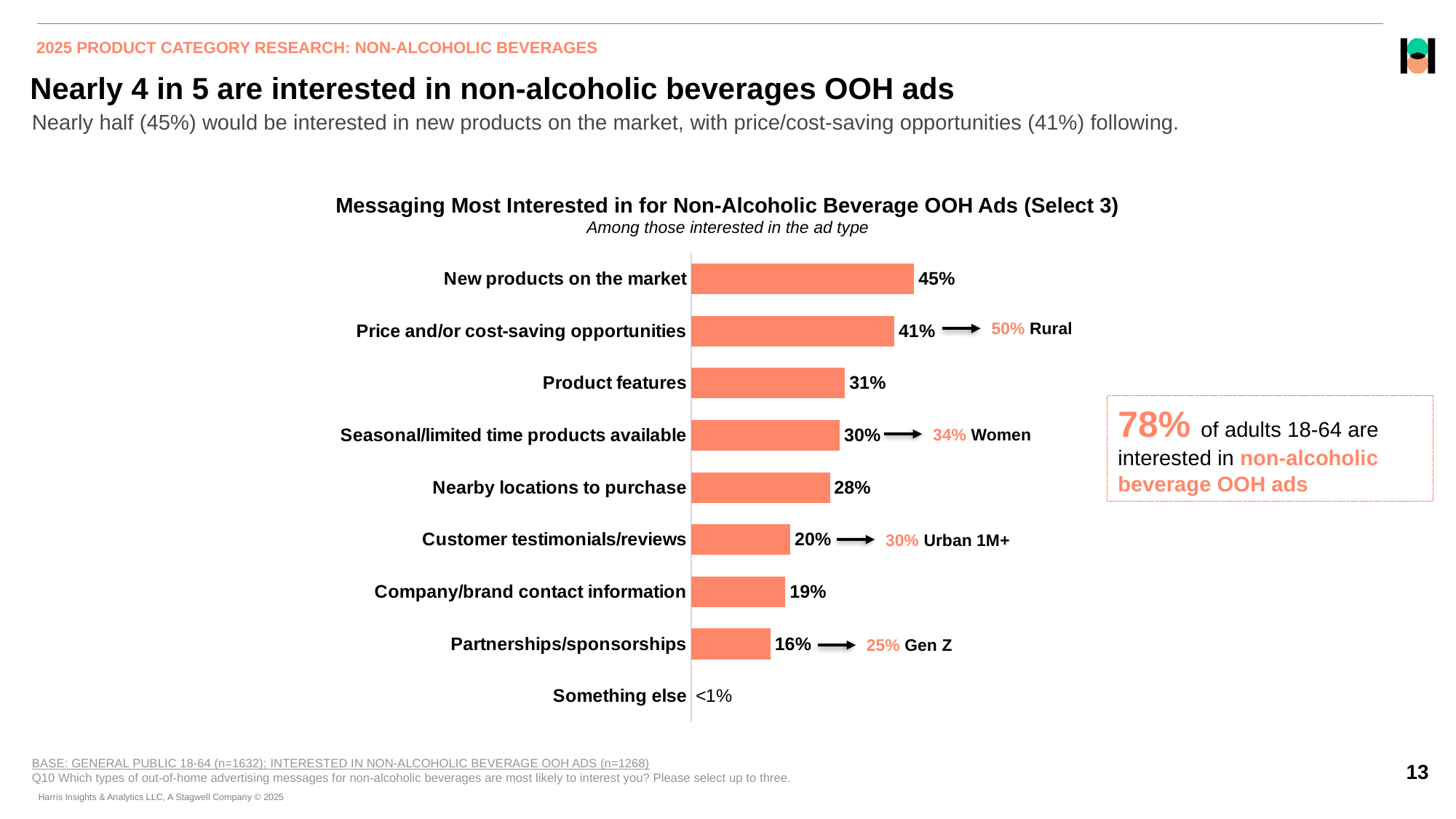
What is the title of the chart? Messaging Most Interested in for Non-Alcoholic Beverage OOH Ads (Select 3) What is the value for Partnerships/sponsorships? 16% What percentage of Rural respondents are interested in price and/or cost-saving opportunities messaging? 50% How many messaging categories are shown in the chart? 9 What is the difference between the values for New products on the market and Price and/or cost-saving opportunities? 4 percentage points Which messaging category has the highest value? New products on the market What percentage are most interested in messaging about new products on the market? 45% What kind of chart is shown on the slide? Bar chart Which is larger: Product features or Customer testimonials/reviews? Product features What is the value for Nearby locations to purchase? 28% Which messaging category has the lowest value? Something else What percentage of Gen Z are interested in partnerships/sponsorships messaging? 25%